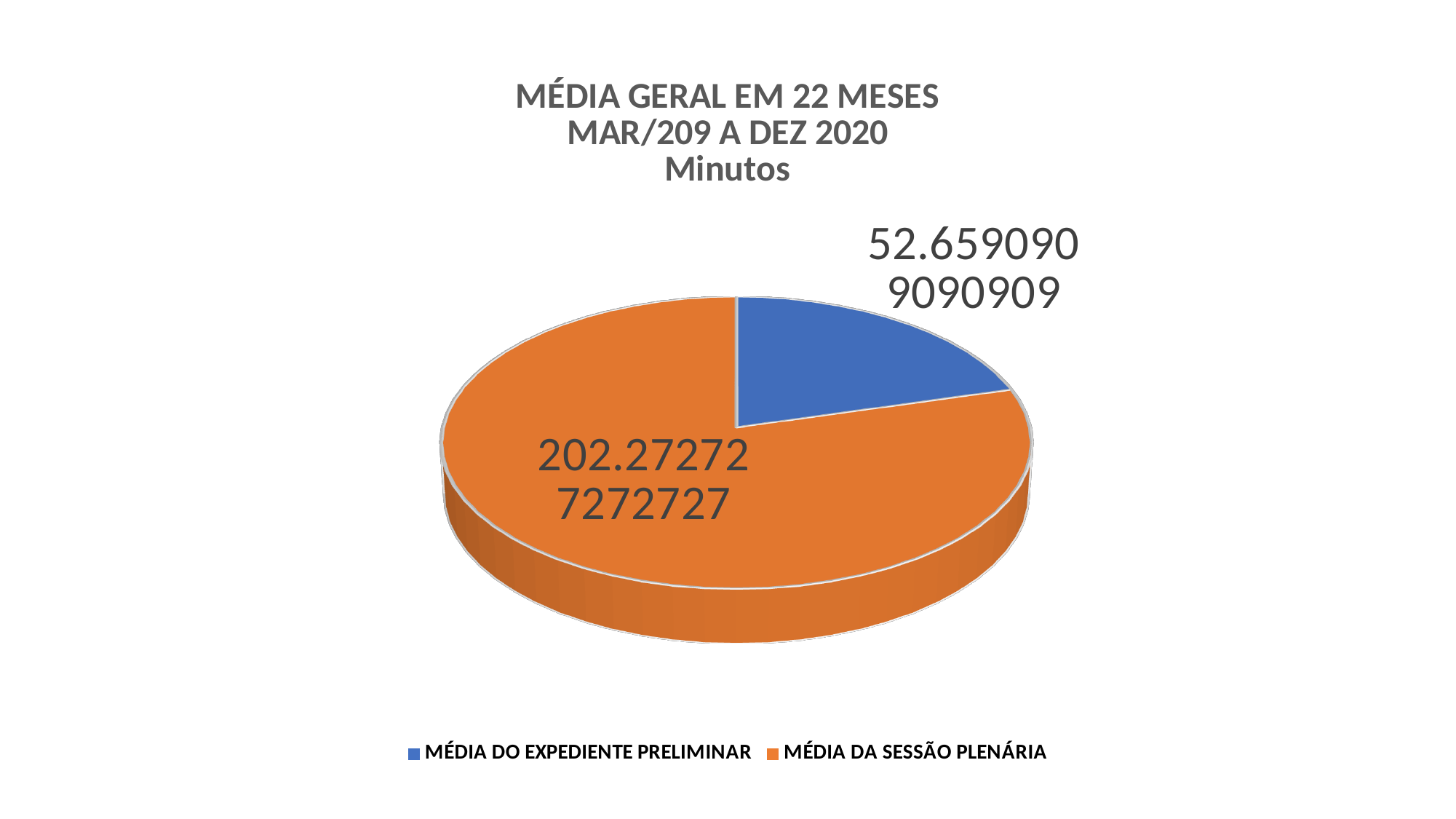
Which colour represents MÉDIA DA SESSÃO PLENÁRIA in the chart? Orange What is the title of the chart? MÉDIA GERAL EM 22 MESES MAR/209 A DEZ 2020 Minutos What is the value shown for MÉDIA DO EXPEDIENTE PRELIMINAR? 52.6590909090909 How many entries does the legend list? 2 How many slices does the pie chart have? 2 Which is larger, MÉDIA DO EXPEDIENTE PRELIMINAR or MÉDIA DA SESSÃO PLENÁRIA? MÉDIA DA SESSÃO PLENÁRIA Which category has the largest slice of the pie? MÉDIA DA SESSÃO PLENÁRIA Which category has the smallest slice of the pie? MÉDIA DO EXPEDIENTE PRELIMINAR What is the value shown for MÉDIA DA SESSÃO PLENÁRIA? 202.272727272727 What kind of chart is shown on the slide? Pie chart